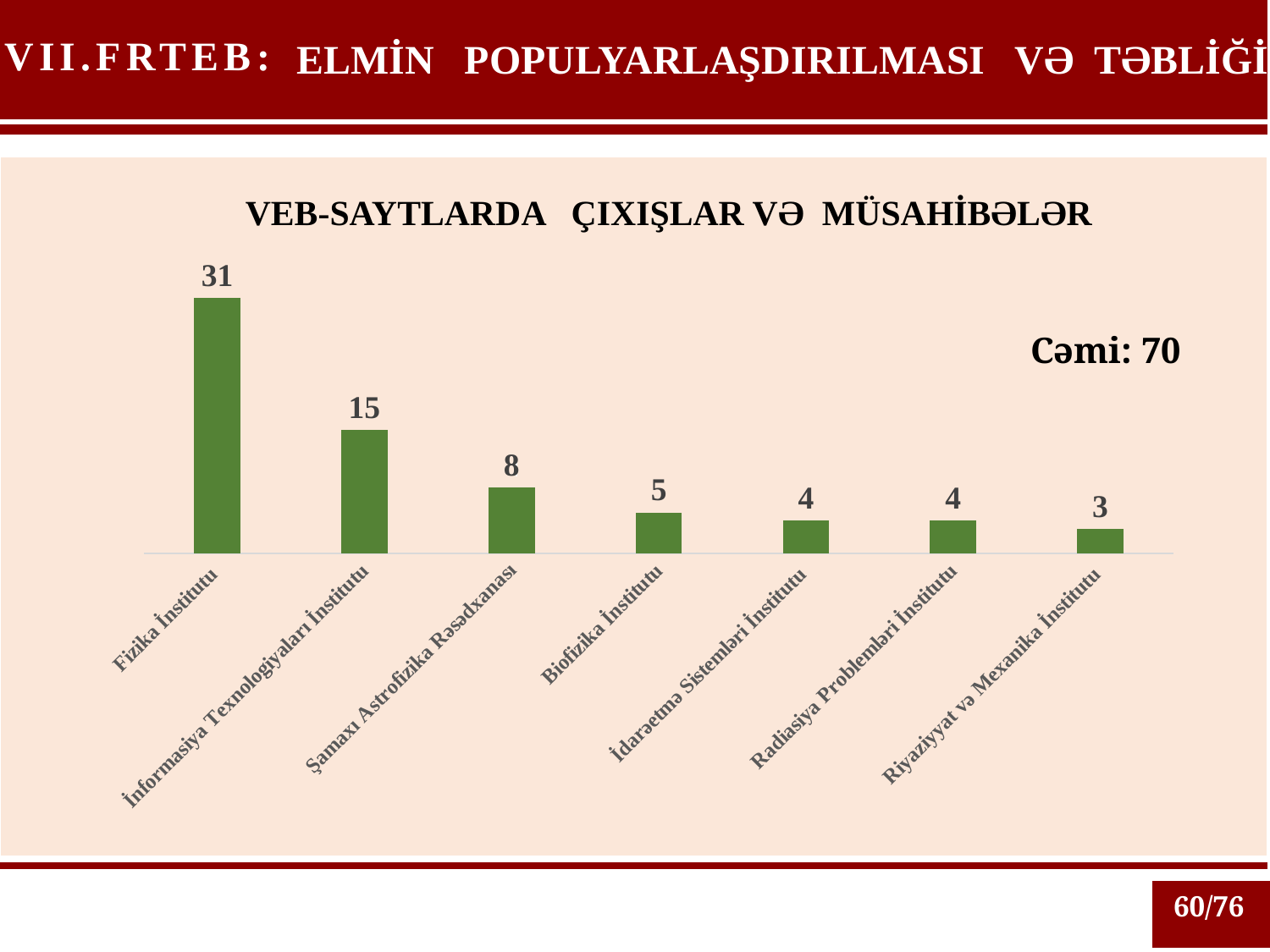
What is the value for Fizika İnstitutu? 31 Which is larger, the value for Şamaxı Astrofizika Rəsədxanası or the value for Biofizika İnstitutu? Şamaxı Astrofizika Rəsədxanası Which category has the highest value? Fizika İnstitutu How many categories are shown in the chart? 7 Which category has the lowest value? Riyaziyyat və Mexanika İnstitutu What is the title of the chart? VEB-SAYTLARDA ÇIXIŞLAR VƏ MÜSAHİBƏLƏR What is the value for Şamaxı Astrofizika Rəsədxanası? 8 What is the value for Biofizika İnstitutu? 5 What is the value for İnformasiya Texnologiyaları İnstitutu? 15 What kind of chart is shown on the slide? Bar chart What is the value for Riyaziyyat və Mexanika İnstitutu? 3 What is the difference between the values for Fizika İnstitutu and İnformasiya Texnologiyaları İnstitutu? 16